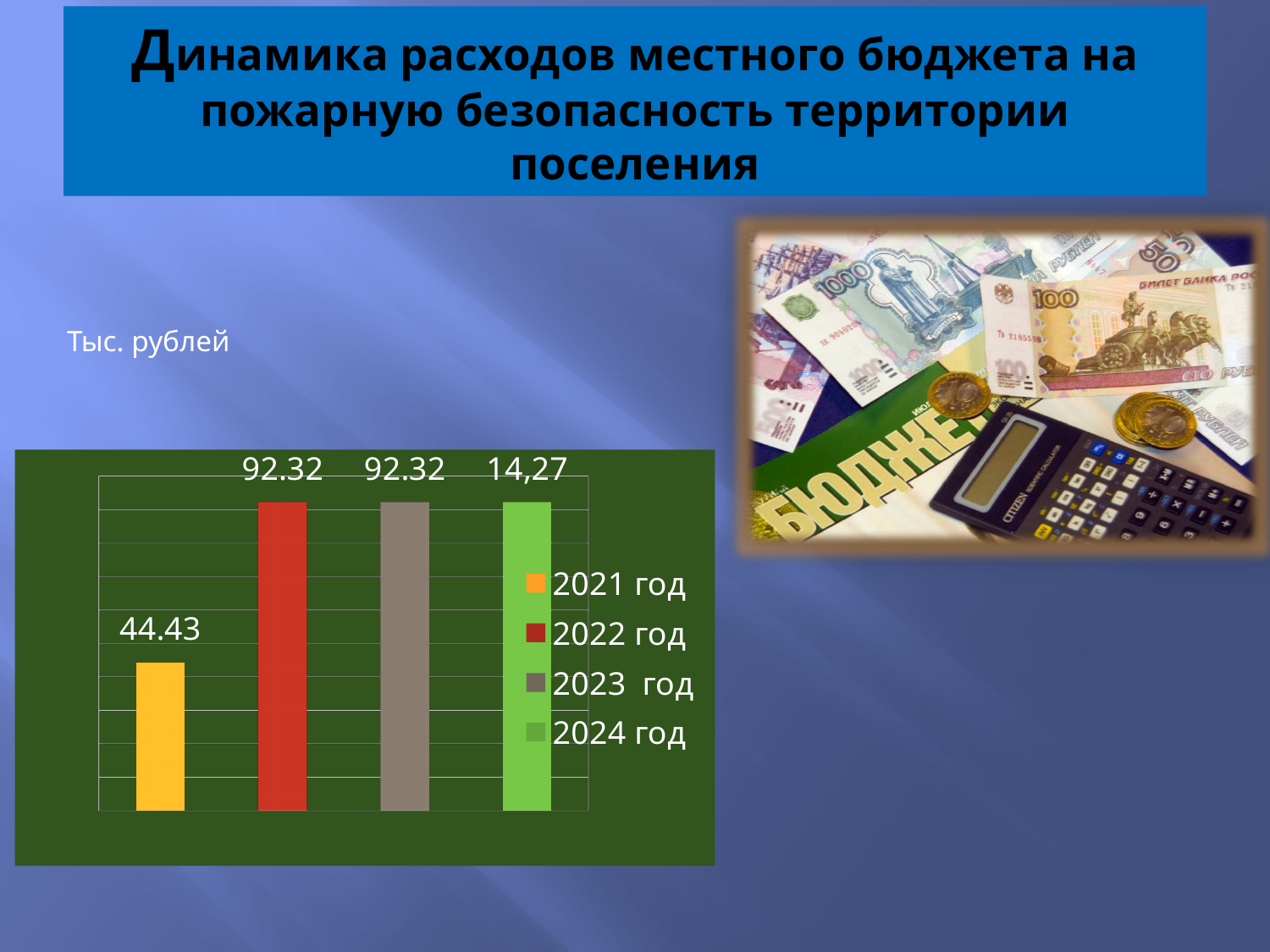
What is the difference between the values for 2022 год and 2021 год? 47.89 What is the value shown for 2023 год? 92.32 Which is larger, the value for 2021 год or the value for 2022 год? 2022 год What colour is the bar for 2022 год? red What is the difference between the values for 2022 год and 2023 год? 0 What is the value shown for 2022 год? 92.32 How many bars are plotted in the chart? 4 What is the value shown for 2021 год? 44.43 How many entries does the legend list? 4 What data label is printed above the bar for 2024 год? 14,27 What kind of chart is shown on the slide? bar chart What unit is stated for the chart values? Тыс. рублей